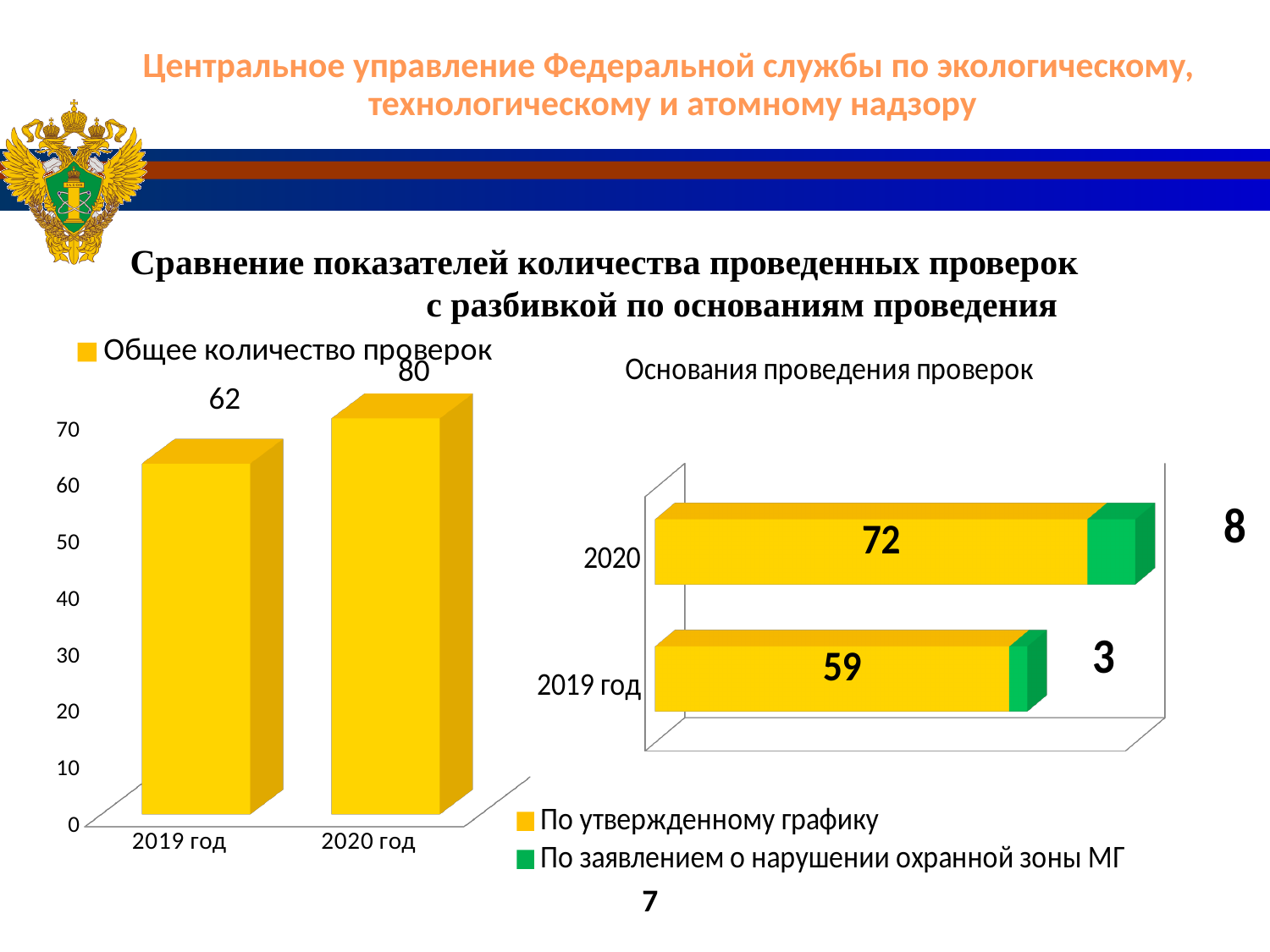
In the right chart (Основания проведения проверок), what is the value for По утвержденному графику in 2020? 72 In the right chart (Основания проведения проверок), what is the total of the stacked bar for 2019 год? 62 In the left chart (Общее количество проверок), which year has the higher value? 2020 год In the right chart (Основания проведения проверок), which is larger: По заявлением о нарушении охранной зоны МГ in 2020 or in 2019 год? 2020 What kind of chart is the left chart (Общее количество проверок)? bar chart In the left chart (Общее количество проверок), what is the difference between the 2020 год and 2019 год values? 18 In the right chart (Основания проведения проверок), what is the total of the stacked bar for 2020? 80 How many series does the legend of the right chart (Основания проведения проверок) list? 2 In the left chart (Общее количество проверок), what is the value for 2019 год? 62 In the right chart (Основания проведения проверок), what is the value for По заявлением о нарушении охранной зоны МГ in 2019 год? 3 In the left chart (Общее количество проверок), what is the value for 2020 год? 80 In the left chart (Общее количество проверок), do the values rise or fall from 2019 год to 2020 год? rise